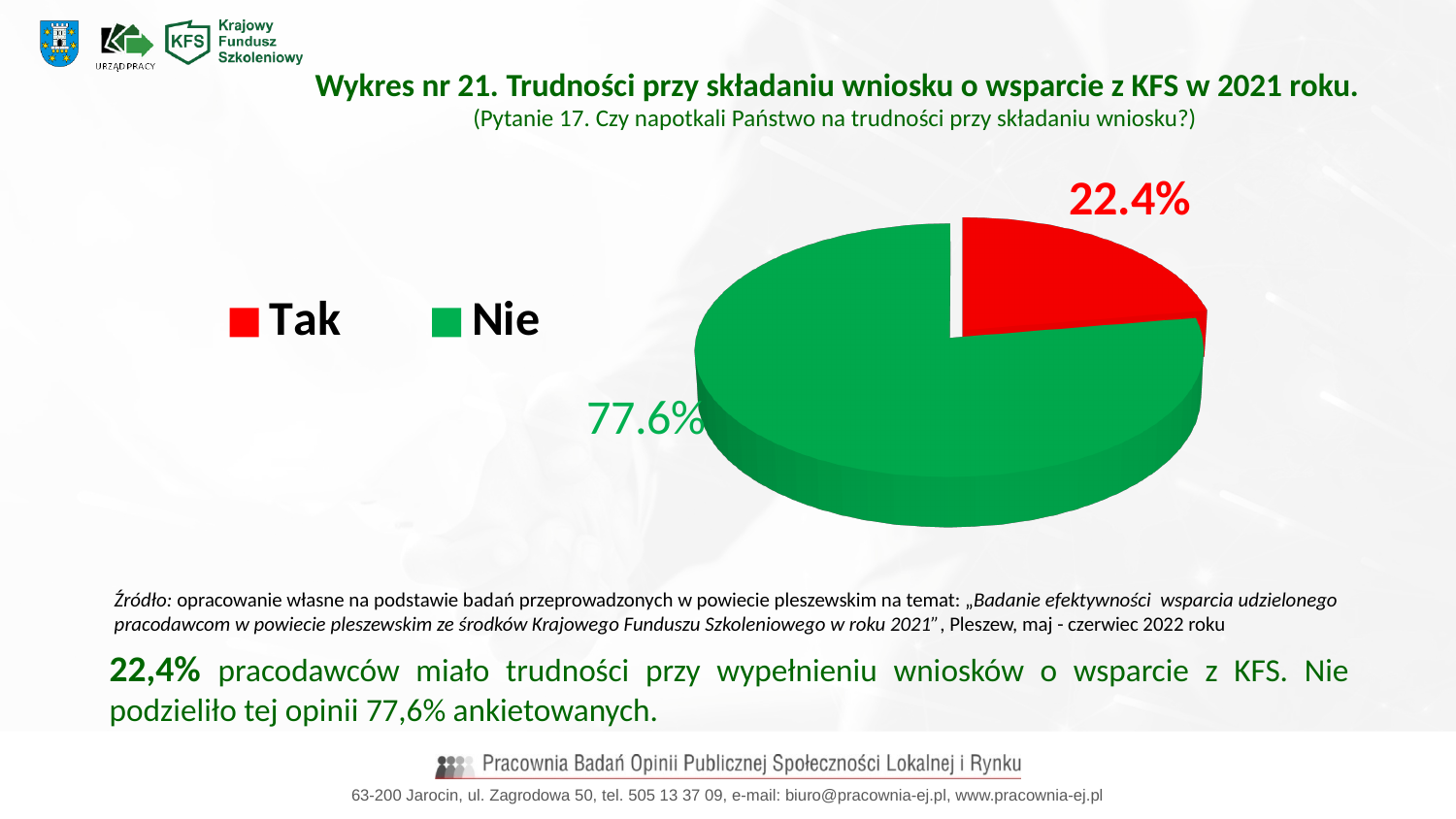
How many categories does the pie chart show? 2 Which category has the largest slice of the pie? Nie What share of the pie does "Nie" represent? 77.6% How many entries does the legend list? 2 What kind of chart is shown on the slide? Pie chart Which category has the smallest slice of the pie? Tak What colour is the "Tak" slice? Red Which slice is larger, "Tak" or "Nie"? Nie What share of the pie does "Tak" represent? 22.4% What is the title of the chart? Wykres nr 21. Trudności przy składaniu wniosku o wsparcie z KFS w 2021 roku. What is the difference in percentage points between the "Nie" and "Tak" slices? 55.2